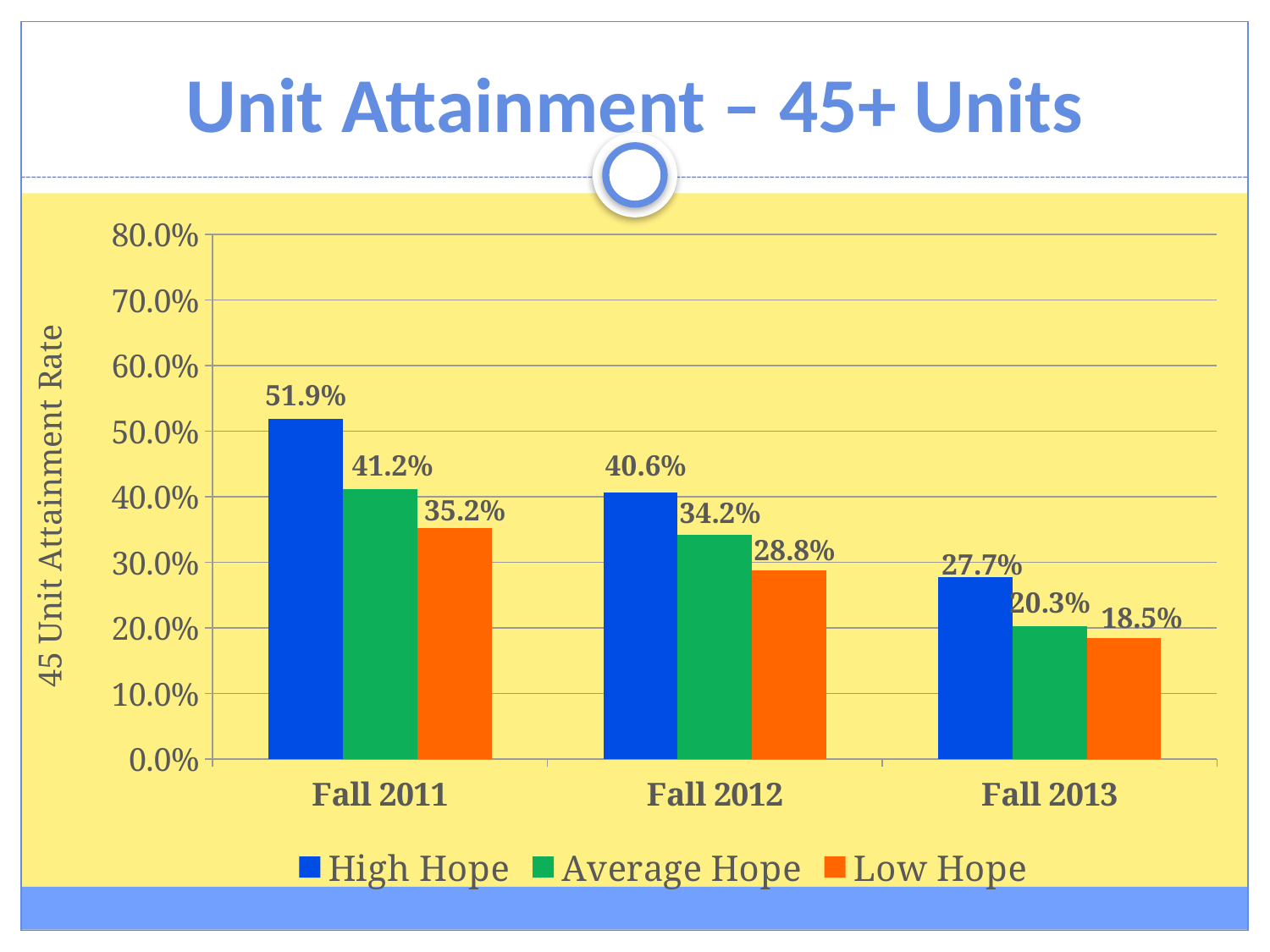
Which series has the lowest 45 unit attainment rate in Fall 2012? Low Hope Is the High Hope attainment rate in Fall 2013 greater or less than 30.0%? less How many terms are shown on the x axis? 3 What is the 45 unit attainment rate for High Hope in Fall 2011? 51.9% What is the difference between the High Hope and Low Hope attainment rates in Fall 2011? 16.7% How many series does the legend list? 3 Which is larger: the Average Hope rate in Fall 2011 or the High Hope rate in Fall 2012? Average Hope in Fall 2011 Does the Low Hope attainment rate rise or fall from Fall 2011 to Fall 2013? fall Which term has the highest 45 unit attainment rate for High Hope? Fall 2011 What is the 45 unit attainment rate for Low Hope in Fall 2013? 18.5% What is the 45 unit attainment rate for Average Hope in Fall 2012? 34.2% What kind of chart is shown on the slide? bar chart